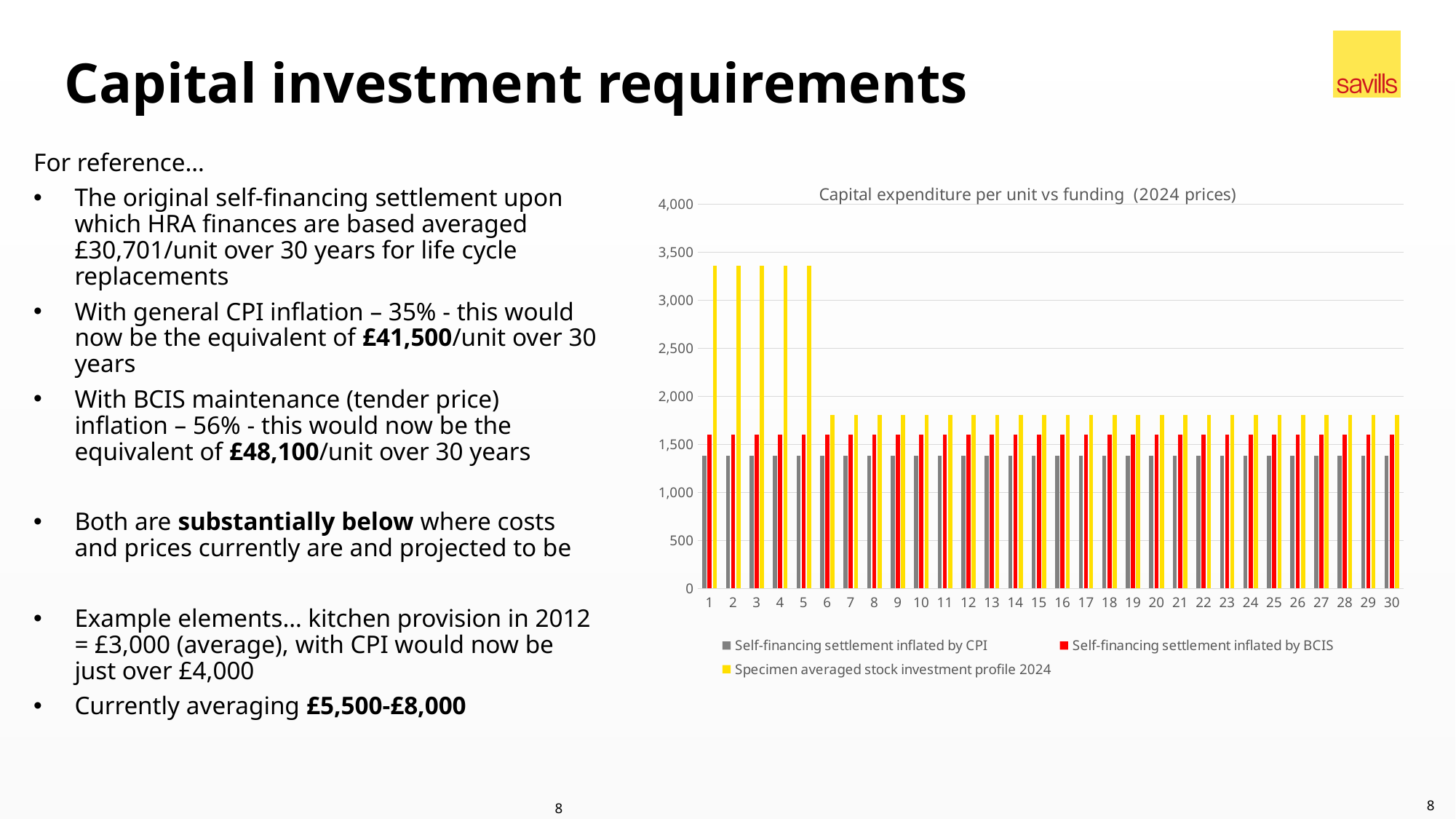
Which series is shown in yellow in the chart? Specimen averaged stock investment profile 2024 Which series has the lowest value in year 20? Self-financing settlement inflated by CPI Which series has the highest value in year 1? Specimen averaged stock investment profile 2024 Is the value for 'Self-financing settlement inflated by CPI' in year 1 greater or less than 1,500? less Is the value for 'Self-financing settlement inflated by BCIS' in year 15 greater or less than 1,500? greater What kind of chart is shown on the slide? Bar chart For 'Specimen averaged stock investment profile 2024', is the value in year 3 larger or smaller than the value in year 8? larger How many series does the chart legend list? 3 Is the value for 'Specimen averaged stock investment profile 2024' in year 1 greater or less than 3,000? greater How many categories (years) are shown along the x axis of the chart? 30 What is the title of the chart? Capital expenditure per unit vs funding (2024 prices)